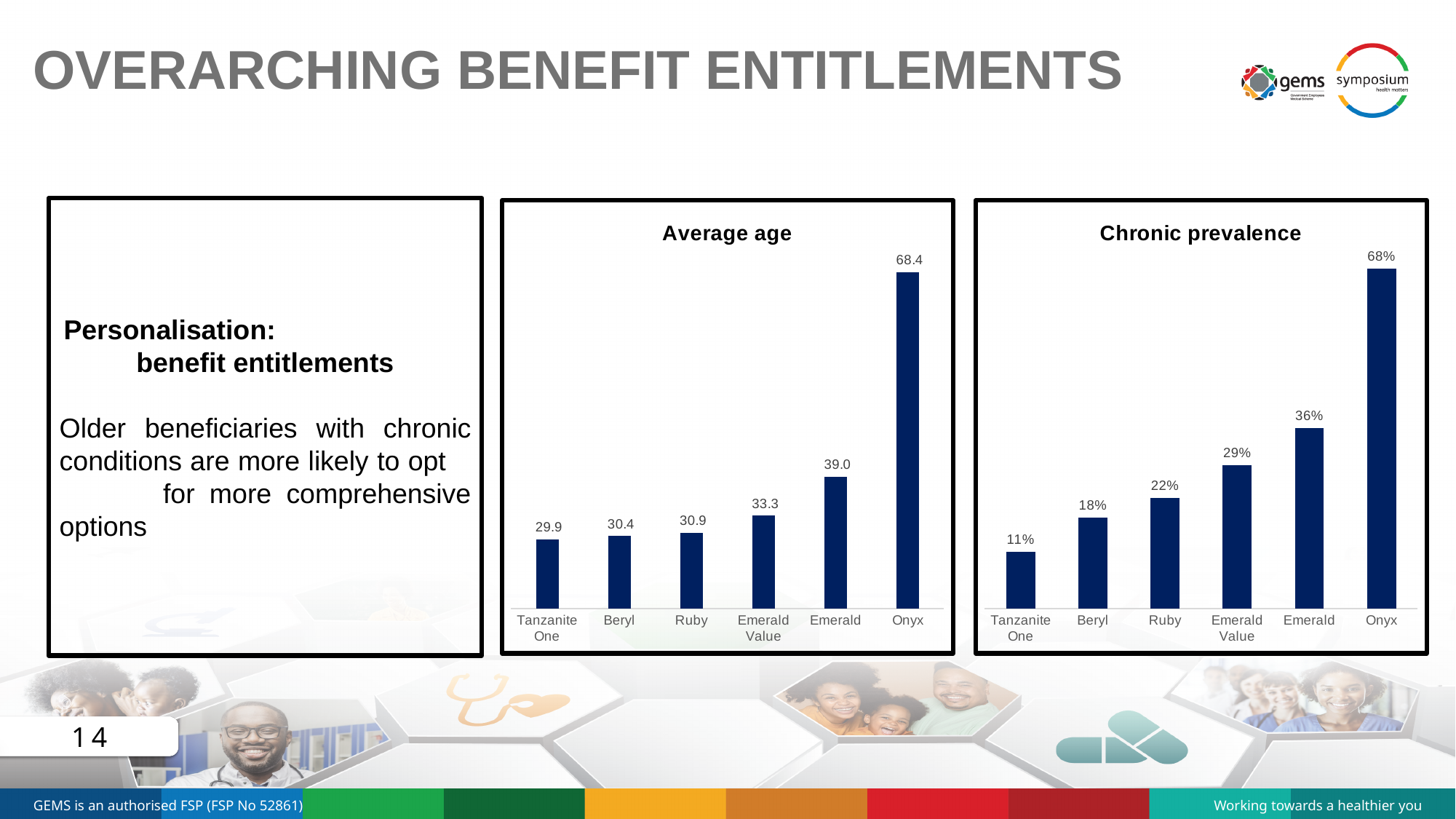
In the Average age chart, what is the difference in average age between Onyx and Emerald? 29.4 What type of chart is the Chronic prevalence chart? Bar chart In the Chronic prevalence chart, which option has the lowest chronic prevalence? Tanzanite One How many options are shown in the Average age chart? 6 What is the title of the chart in the middle of the slide? Average age In the Average age chart, what is the average age for Emerald Value? 33.3 In the Chronic prevalence chart, do the values rise or fall from Tanzanite One to Onyx? Rise In the Chronic prevalence chart, what is the chronic prevalence for Ruby? 22% In the Chronic prevalence chart, what is the difference in chronic prevalence between Emerald and Beryl? 18% In the Average age chart, which option has the highest average age? Onyx In the Average age chart, what is the average age for Onyx? 68.4 In the Chronic prevalence chart, which has a higher chronic prevalence, Emerald Value or Ruby? Emerald Value